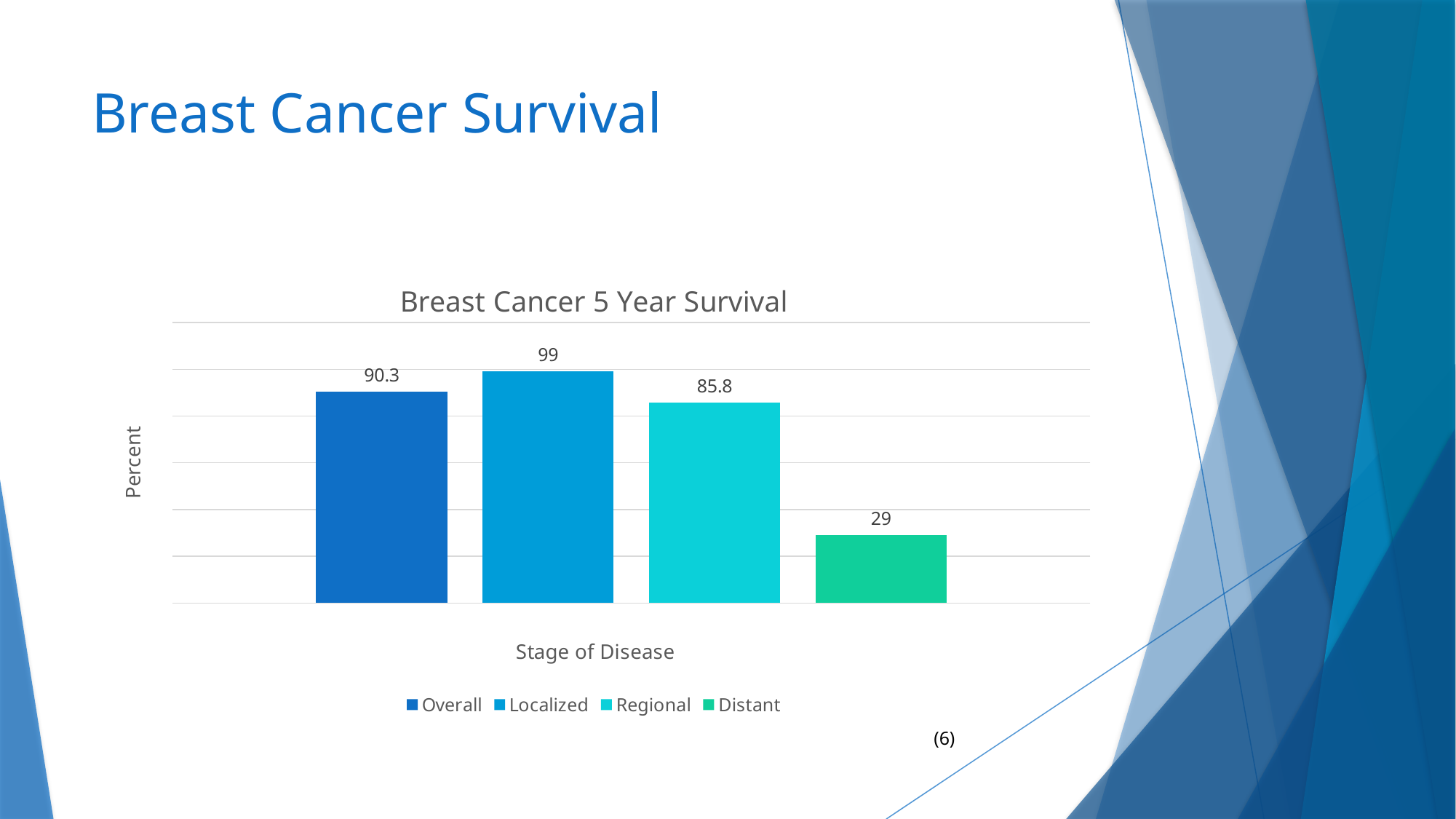
Which stage has the highest 5 year survival value? Localized What type of chart is shown on the slide? Bar chart What is the value shown for Distant? 29 What is the 5 year survival value for Localized? 99 How many bars are plotted in the chart? 4 Which stage has the lowest 5 year survival value? Distant What is the title of the chart? Breast Cancer 5 Year Survival What is the difference between the Localized and Distant values? 70 Which is larger, the value for Overall or the value for Regional? Overall What is the difference between the Overall and Regional values? 4.5 What is the value shown for Regional? 85.8 What is the value shown for Overall? 90.3